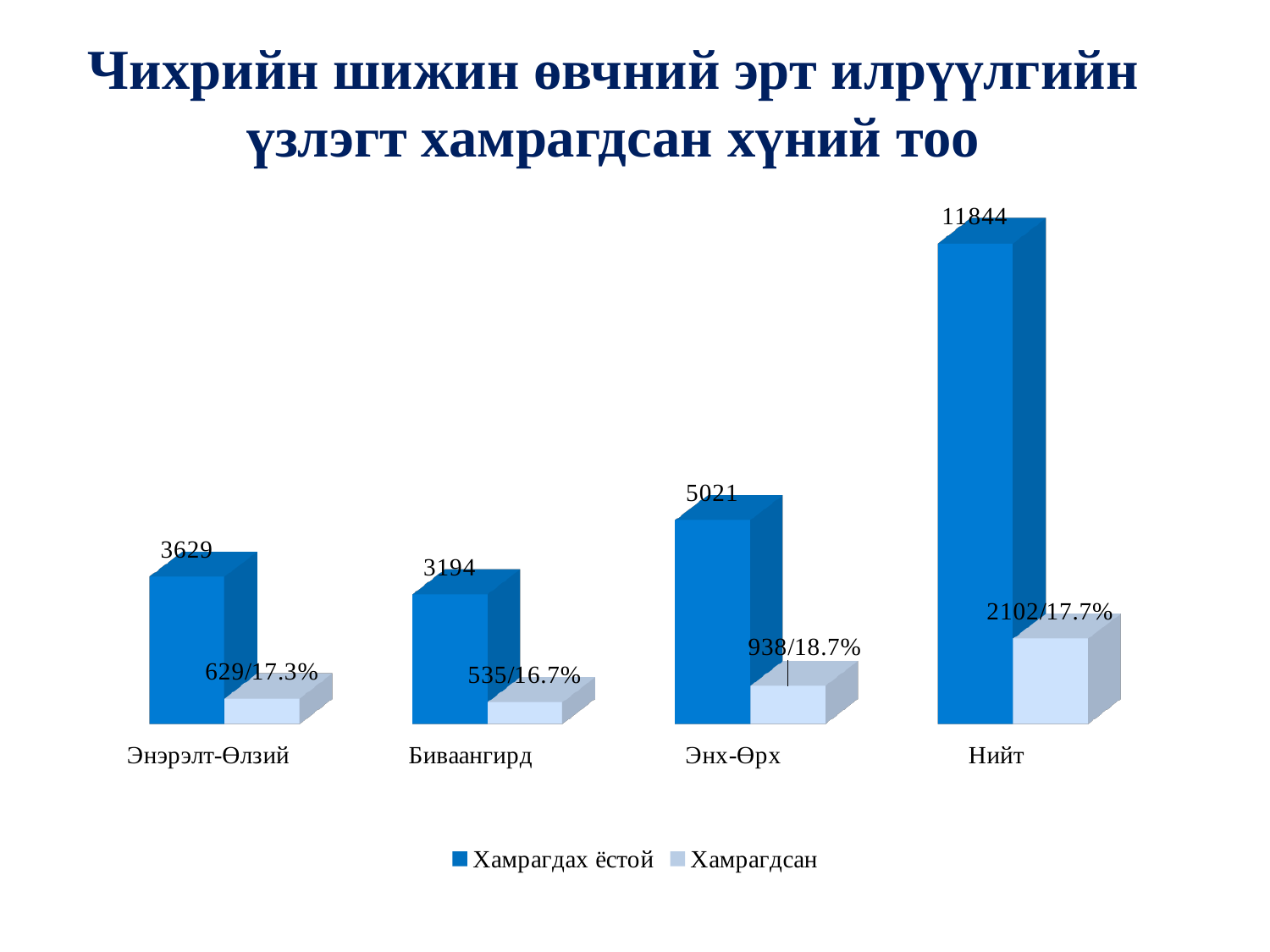
What is the data label shown for Хамрагдсан for Энэрэлт-Өлзий? 629/17.3% How many categories are shown on the x axis? 4 What kind of chart is shown on the slide? Bar chart Which series is shown in dark blue according to the legend? Хамрагдах ёстой What is the value of Хамрагдах ёстой for Нийт? 11844 What is the value of Хамрагдах ёстой for Энх-Өрх? 5021 Which is larger, the Хамрагдах ёстой value for Энэрэлт-Өлзий or for Биваангирд? Энэрэлт-Өлзий What is the difference between the Хамрагдах ёстой values for Энх-Өрх and Энэрэлт-Өлзий? 1392 Which category has the highest Хамрагдах ёстой value? Нийт How many series does the legend list? 2 Among the three districts (excluding Нийт), which has the lowest Хамрагдах ёстой value? Биваангирд What is the data label shown for Хамрагдсан for Биваангирд? 535/16.7%